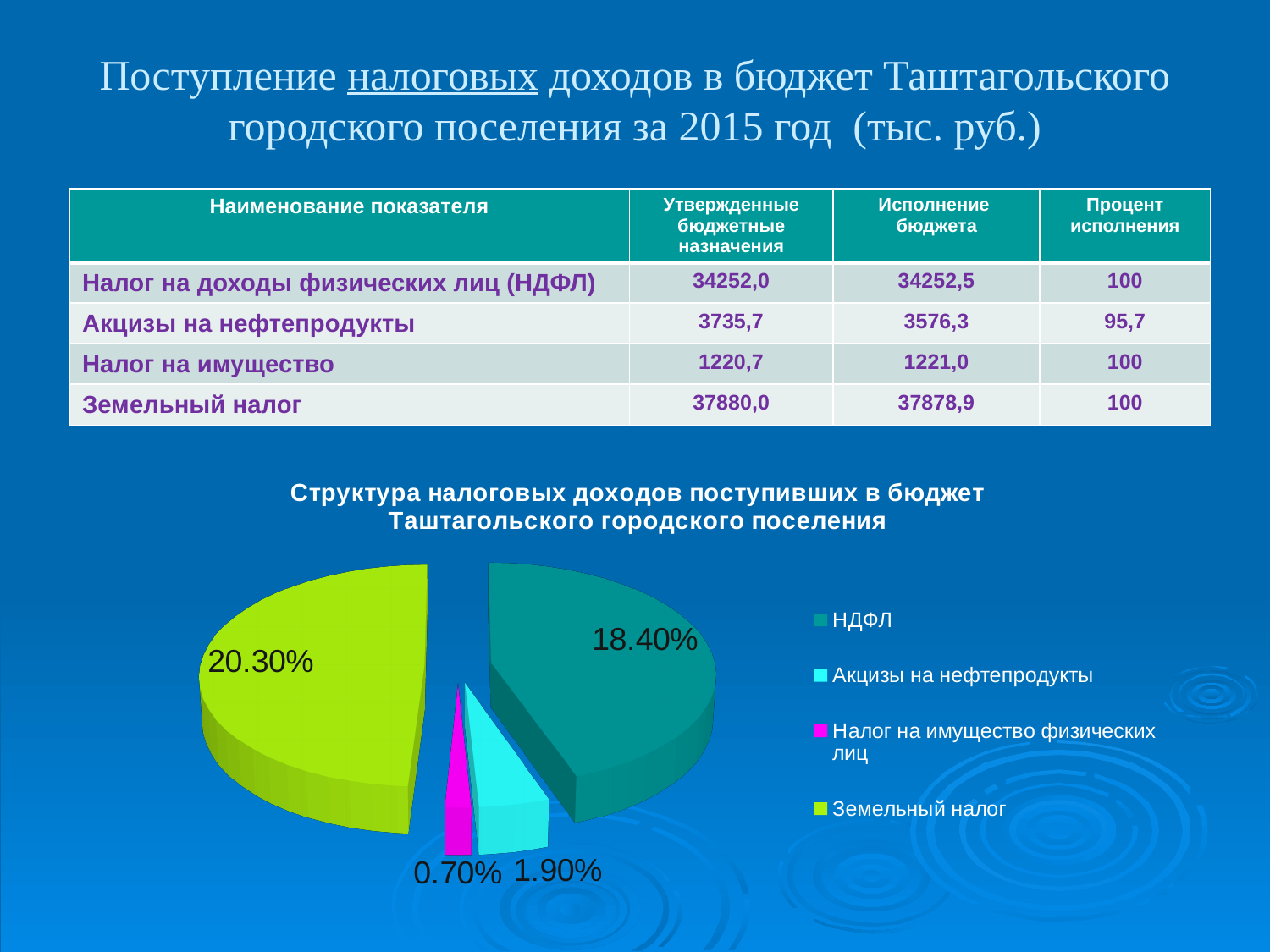
What percentage is shown for Земельный налог in the pie chart? 20.30% How many entries does the legend of the pie chart list? 4 Which slice of the pie chart is the smallest? Налог на имущество физических лиц What percentage is shown for Акцизы на нефтепродукты in the pie chart? 1.90% Which slice of the pie chart is the largest? Земельный налог What is the title of the pie chart? Структура налоговых доходов поступивших в бюджет Таштагольского городского поселения What kind of chart is shown on the slide? Pie chart What percentage is shown for НДФЛ in the pie chart? 18.40% What is the difference between the percentages shown for Земельный налог and НДФЛ in the pie chart? 1.90% What percentage is shown for Налог на имущество физических лиц in the pie chart? 0.70% How many slices does the pie chart have? 4 Which is larger in the pie chart, НДФЛ or Акцизы на нефтепродукты? НДФЛ